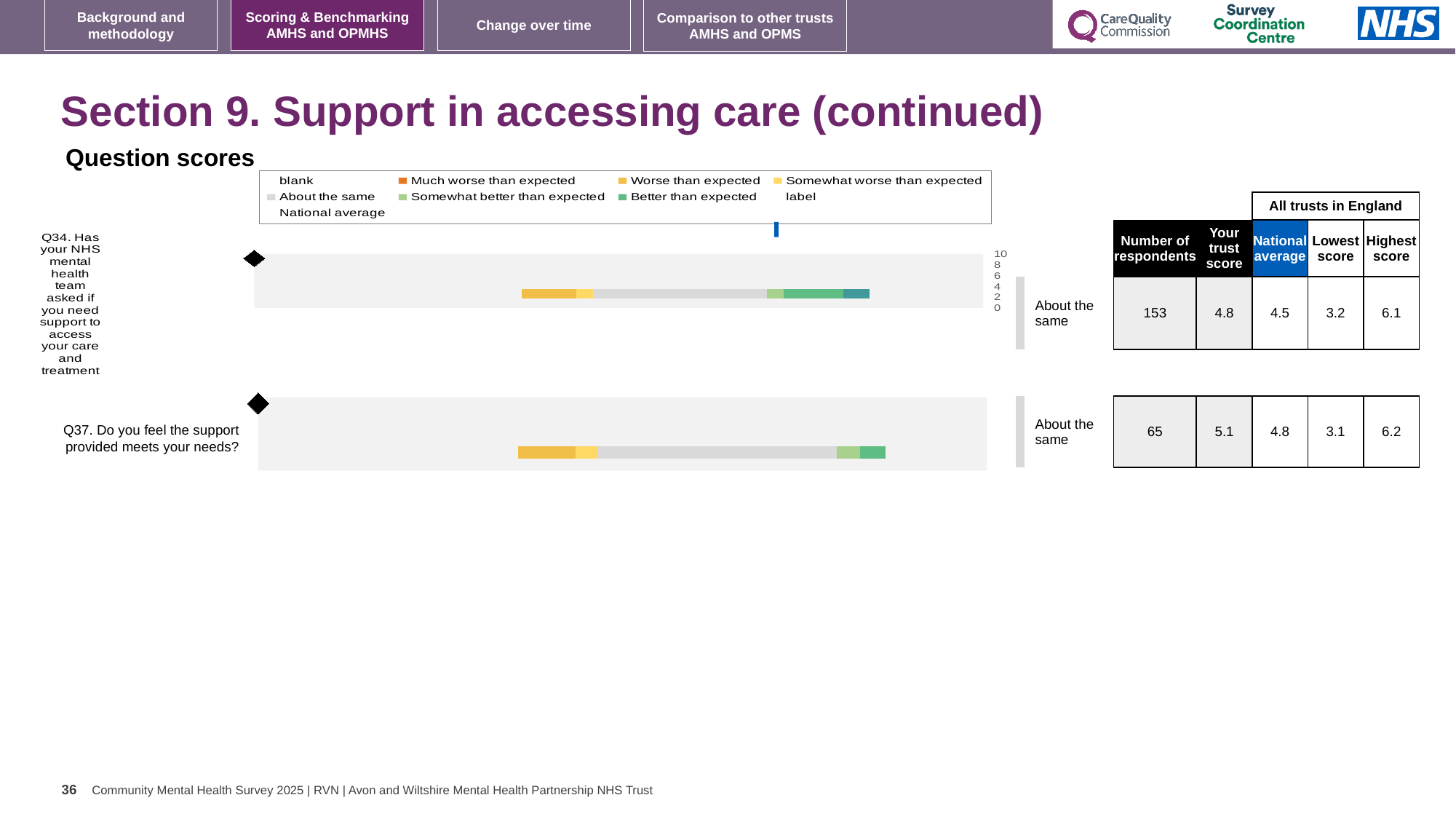
What is the trust score for Q34 (Has your NHS mental health team asked if you need support to access your care and treatment)? 4.8 How many questions are plotted in the question scores chart? 2 What is the lowest score among all trusts in England for Q34? 3.2 What kind of chart is used to show the question scores on this slide? bar chart Which question has the higher trust score, Q34 or Q37? Q37 What is the highest score among all trusts in England for Q37? 6.2 How many respondents answered Q37 (Do you feel the support provided meets your needs)? 65 What is the difference between the highest score and the lowest score for Q37? 3.1 What heading appears above the National average, Lowest score and Highest score columns in the table? All trusts in England For Q34, which is larger: the trust score or the national average? the trust score What is the national average score for Q34? 4.5 What benchmark category is shown next to the bar for Q34? About the same